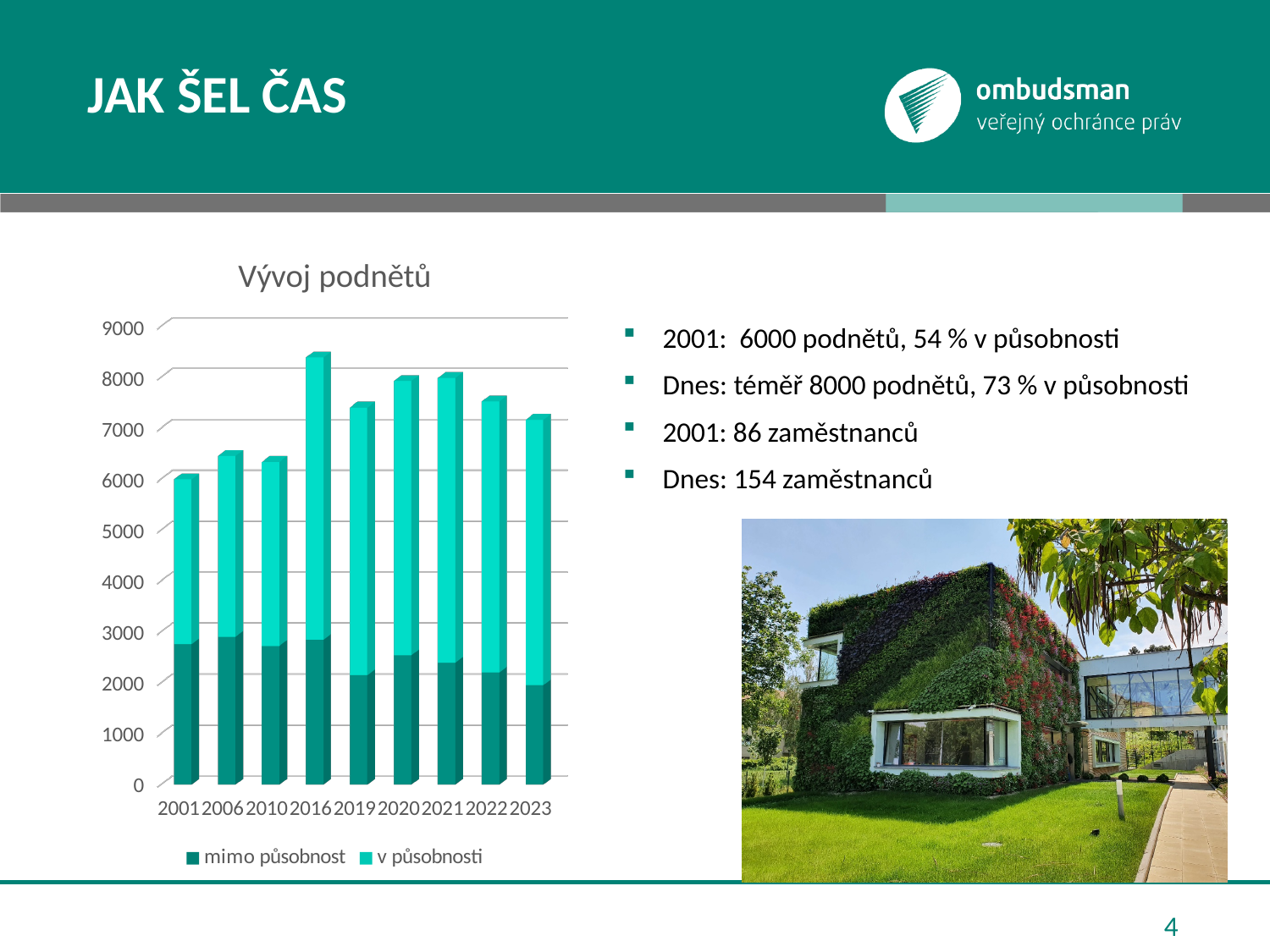
What is the title of the chart? Vývoj podnětů How many years are shown on the x axis of the chart? 9 Is the total bar for 2001 greater or less than 7000? less Which two series are listed in the chart's legend? mimo působnost and v působnosti What kind of chart is shown on the slide? stacked bar chart Which year has the larger total bar, 2019 or 2020? 2020 Which year has the tallest total bar in the chart? 2016 Which year has the larger total bar, 2016 or 2023? 2016 Is the total bar for 2016 greater or less than 8000? greater How many series does the chart's legend list? 2 Which year has the shortest total bar in the chart? 2001